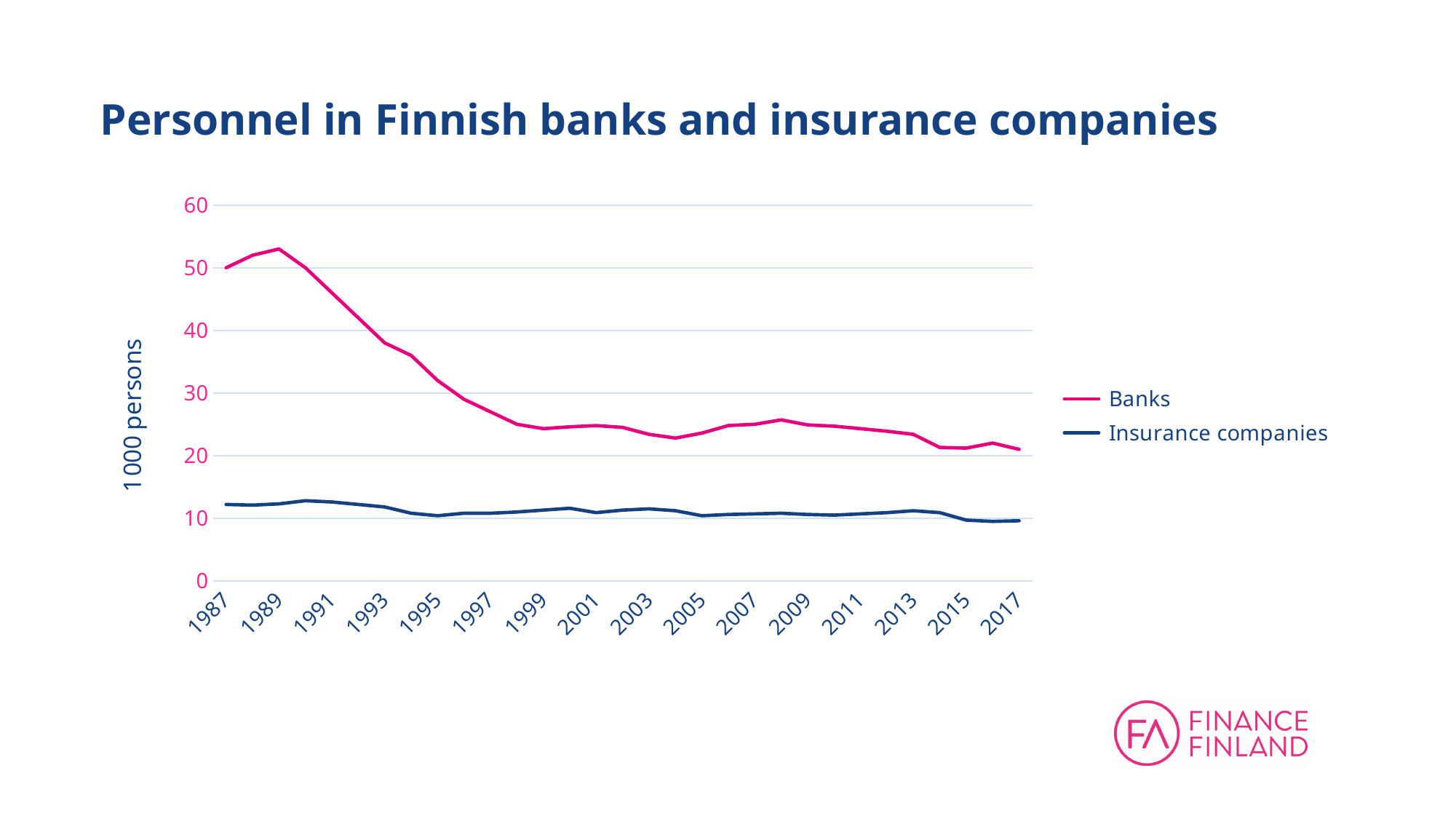
Is the value for Banks in 1991 greater or less than 40? greater In which year does the Banks series reach its highest value? 1989 Is the value for Banks in 2017 greater or less than 30? less What kind of chart is shown on the slide? line chart Does the Banks series rise or fall overall from 1987 to 2017? fall Is the value for Banks in 1989 greater or less than 50? greater Which series does the legend list besides Banks? Insurance companies What is the label on the vertical axis? 1000 persons Which series has the higher value in 2017, Banks or Insurance companies? Banks How many year labels are shown on the x axis? 16 How many series does the legend list? 2